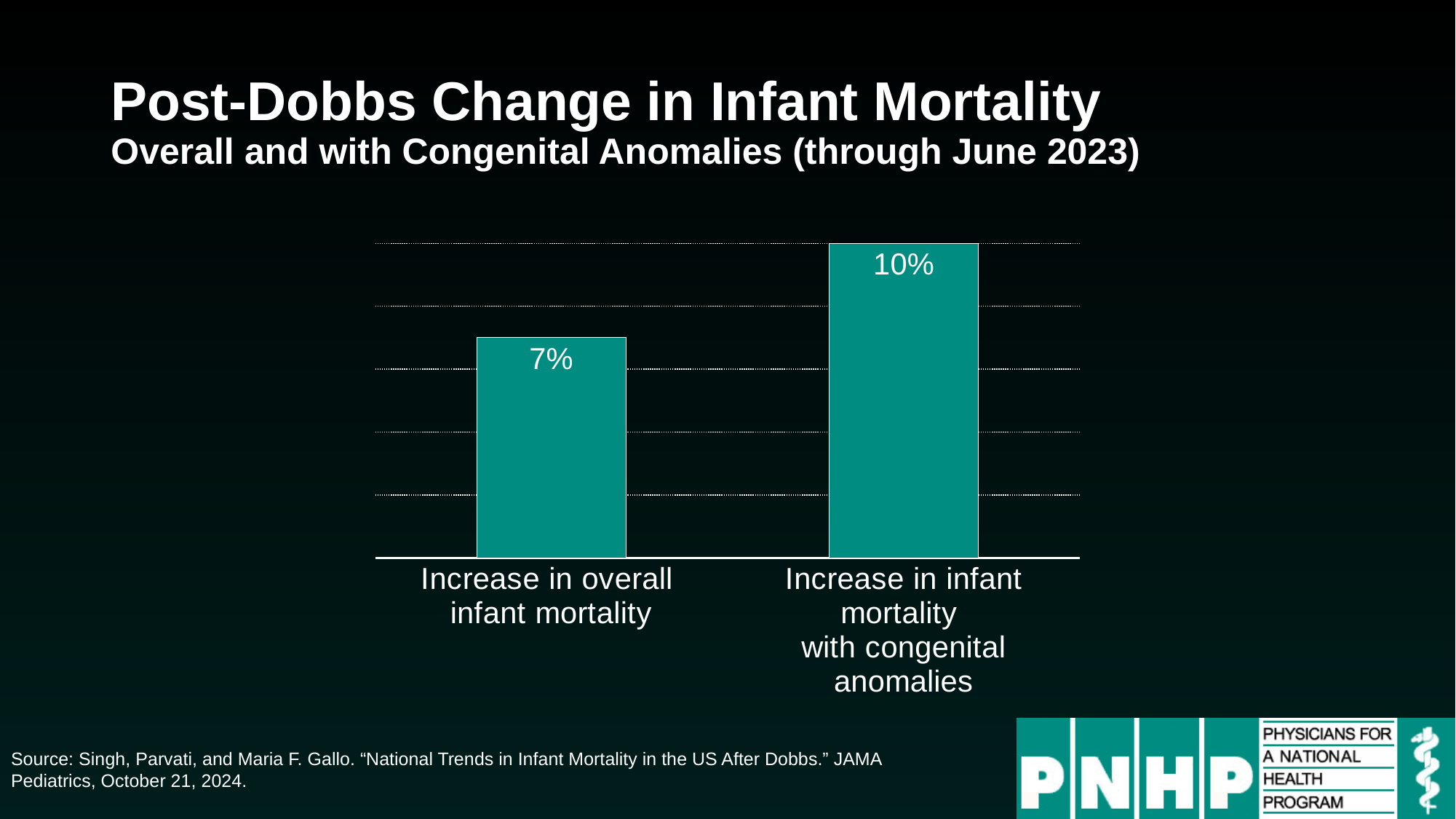
What is the value for 'Increase in overall infant mortality'? 7% What is the value for 'Increase in infant mortality with congenital anomalies'? 10% What is the title of the slide? Post-Dobbs Change in Infant Mortality What is the difference between the increase in infant mortality with congenital anomalies and the increase in overall infant mortality? 3% How many categories are shown in the chart? 2 What colour are the bars in the chart? Teal Which category has the highest value? Increase in infant mortality with congenital anomalies What kind of chart is shown on the slide? Bar chart Which is larger: the increase in overall infant mortality or the increase in infant mortality with congenital anomalies? Increase in infant mortality with congenital anomalies Which category has the lowest value? Increase in overall infant mortality